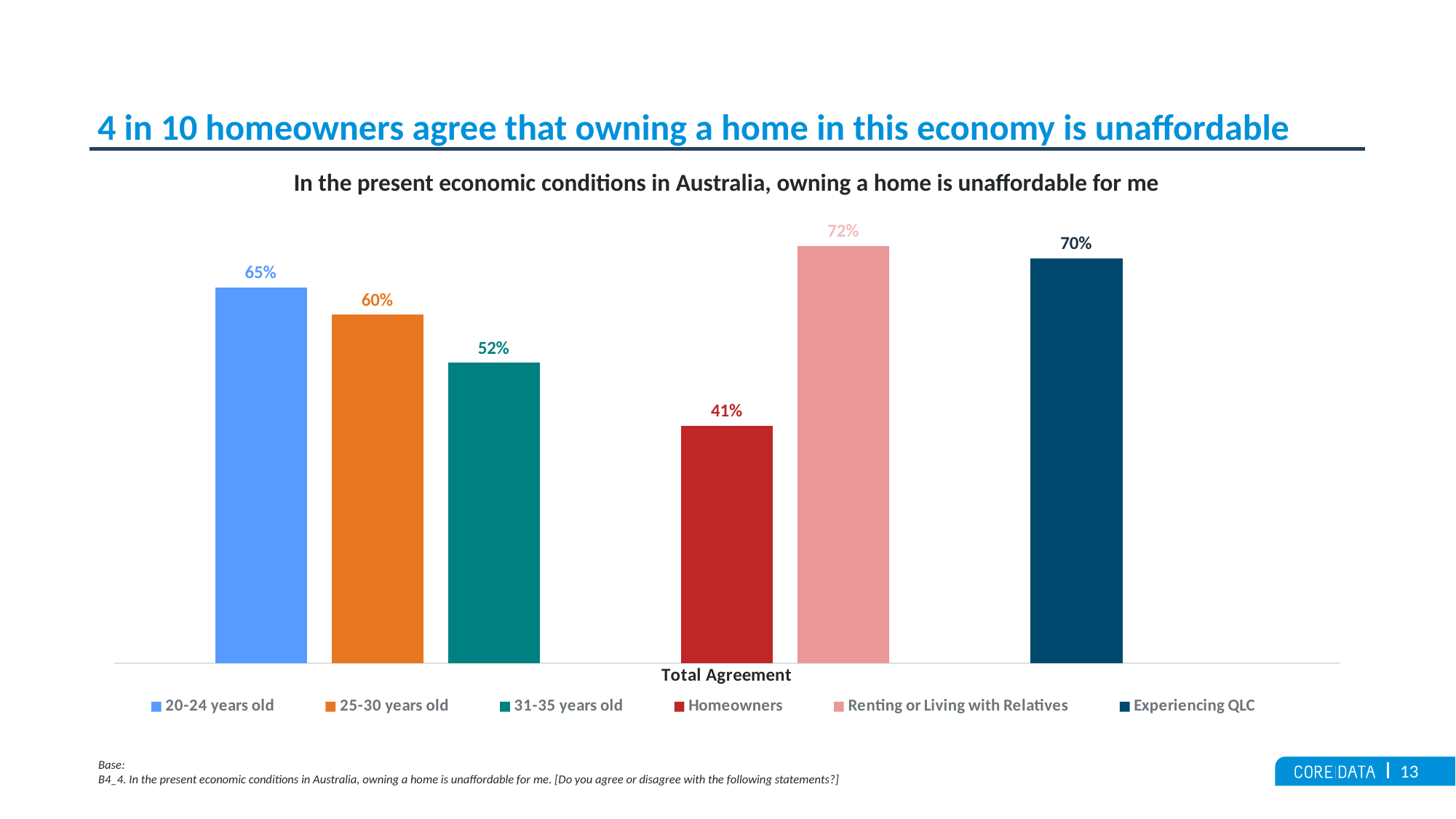
What is the difference between the values for Renting or Living with Relatives and Homeowners? 31% Which series has the lowest value? Homeowners What kind of chart is shown on the slide? Bar chart What is the value for Experiencing QLC? 70% What is the value for Renting or Living with Relatives? 72% What is the title of the chart? In the present economic conditions in Australia, owning a home is unaffordable for me Which is larger, the value for 25-30 years old or the value for 31-35 years old? 25-30 years old What is the value for Homeowners? 41% Which series has the highest value? Renting or Living with Relatives What is the value for 20-24 years old? 65% How many series does the legend list? 6 What is the difference between the values for 20-24 years old and 31-35 years old? 13%